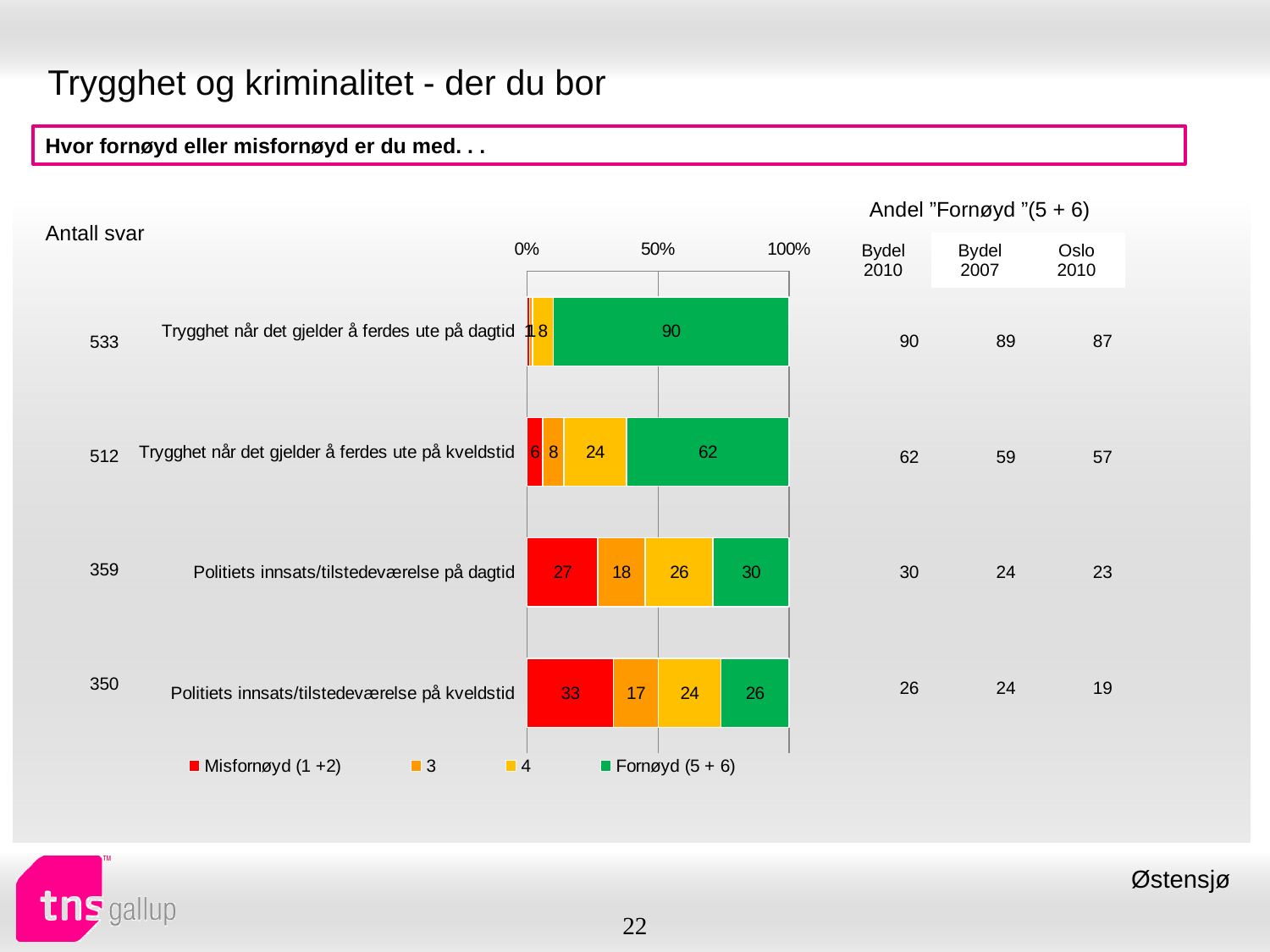
Which has the larger "Misfornøyd (1 +2)" value: "Politiets innsats/tilstedeværelse på dagtid" or "Politiets innsats/tilstedeværelse på kveldstid"? Politiets innsats/tilstedeværelse på kveldstid How many series does the chart legend list? 4 What is the difference between the "Fornøyd (5 + 6)" values for "Trygghet når det gjelder å ferdes ute på dagtid" and "Trygghet når det gjelder å ferdes ute på kveldstid"? 28 What is the value of series "3" for "Politiets innsats/tilstedeværelse på dagtid"? 18 How many categories (rows) does the bar chart show? 4 What is the value of "Misfornøyd (1 +2)" for "Politiets innsats/tilstedeværelse på kveldstid"? 33 Which category has the highest "Fornøyd (5 + 6)" value? Trygghet når det gjelder å ferdes ute på dagtid Which category has the lowest "Fornøyd (5 + 6)" value? Politiets innsats/tilstedeværelse på kveldstid What is the total of the stacked bar for "Politiets innsats/tilstedeværelse på kveldstid"? 100 What kind of chart is shown on the slide? bar chart What is the value of "Fornøyd (5 + 6)" for "Trygghet når det gjelder å ferdes ute på dagtid"? 90 What is the value of series "4" for "Trygghet når det gjelder å ferdes ute på kveldstid"? 24